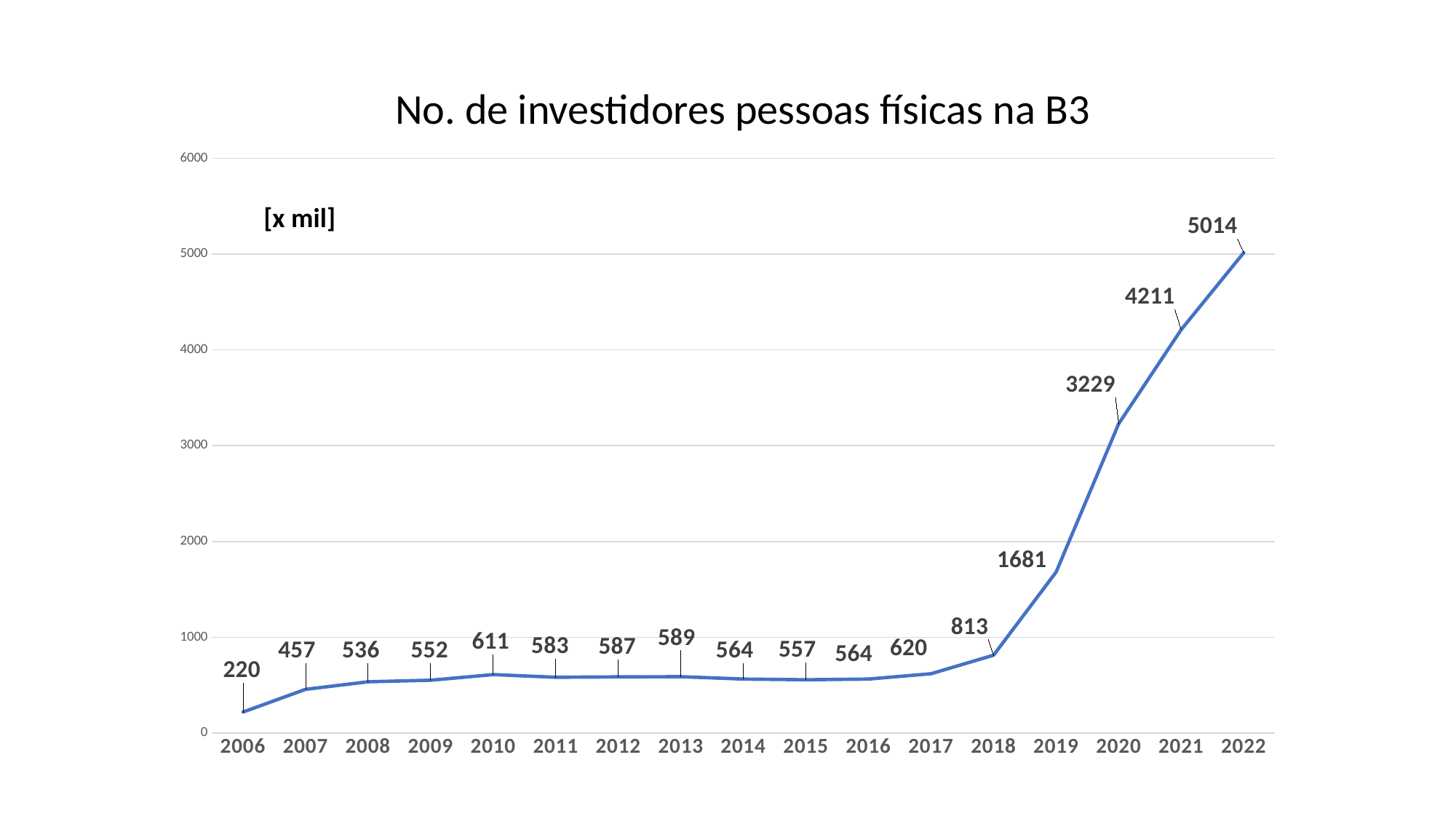
What is the value for 2022? 5014 Which year has the highest value? 2022 What is the value for 2006? 220 What is the title of the chart? No. de investidores pessoas físicas na B3 Which is larger, the value for 2010 or the value for 2017? 2017 What kind of chart is shown? line chart Do the values rise or fall from 2018 to 2022? rise Which year has the lowest value? 2006 What is the value for 2018? 813 What is the difference between the values for 2022 and 2021? 803 How many years are plotted on the x axis? 17 Is the value for 2020 greater or less than 3000? greater